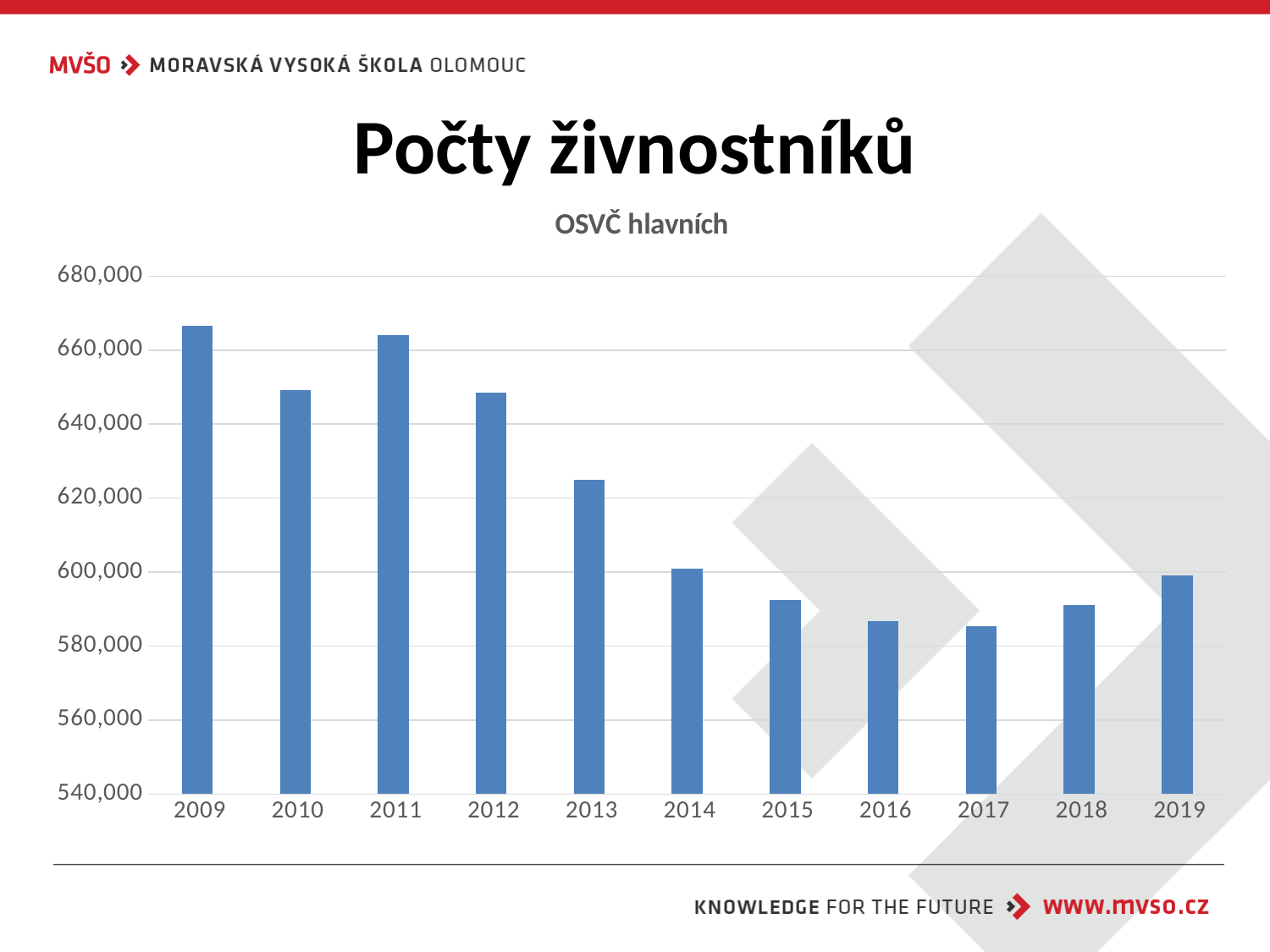
What is the title of the chart? OSVČ hlavních Is the value for 2017 greater or less than 580,000? greater Which year has the larger value, 2013 or 2018? 2013 Is the value for 2015 greater or less than 600,000? less Is the value for 2013 greater or less than 620,000? greater Which year has the larger value, 2016 or 2019? 2019 What kind of chart is shown on the slide? bar chart Which year has the larger value, 2009 or 2010? 2009 Do the values generally rise or fall from 2009 to 2017? fall How many years are shown on the x axis of the chart? 11